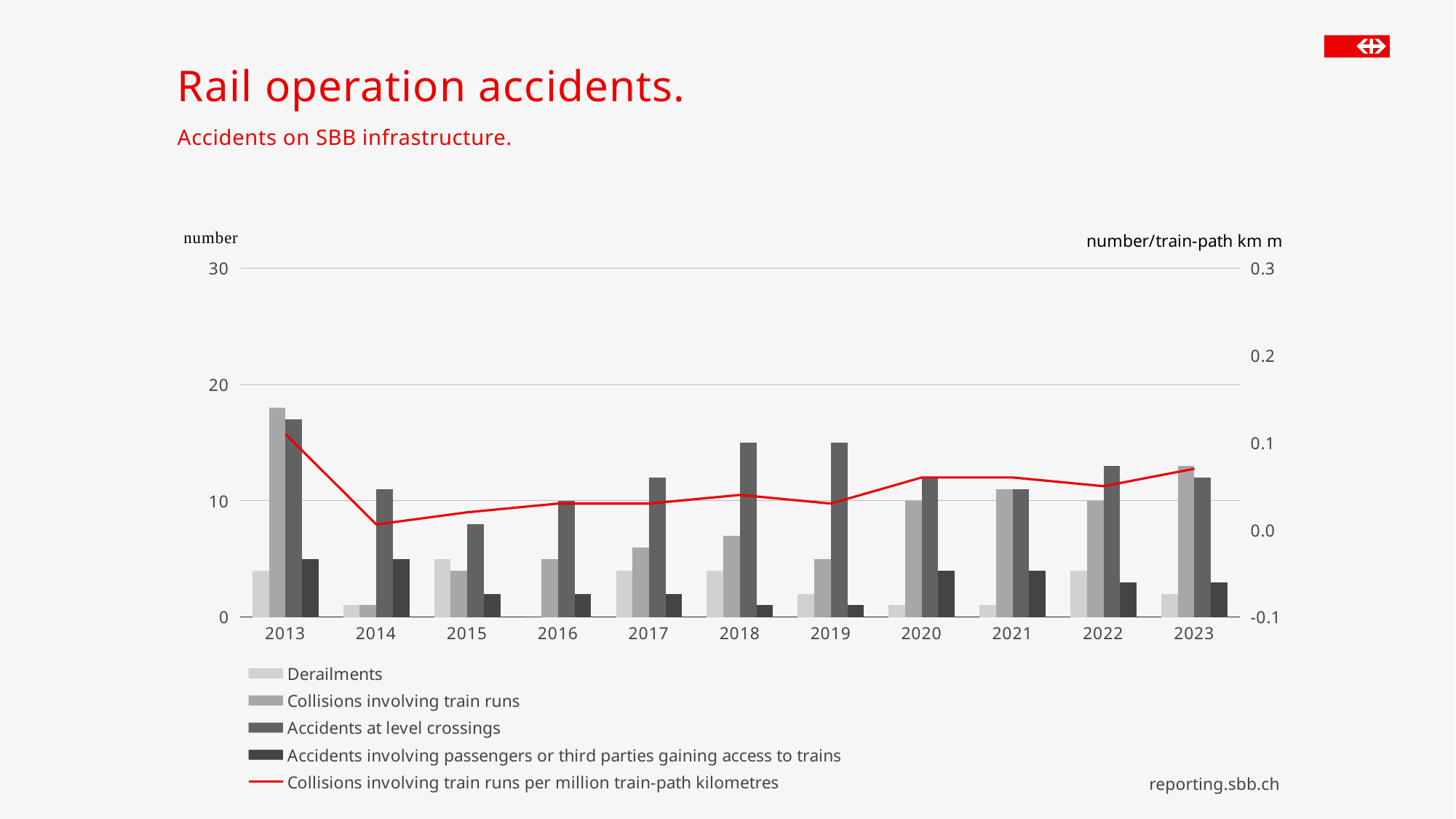
What is the title of the chart slide? Rail operation accidents. How many series does the legend list? 5 In which year is the value for Collisions involving train runs highest? 2013 Is the value for Collisions involving train runs in 2013 greater or less than 10? greater In which year is the value for Accidents at level crossings highest? 2013 Which is larger: Accidents at level crossings in 2017 or in 2015? 2017 How many years are shown on the x axis of the chart? 11 Does the line for Collisions involving train runs per million train-path kilometres rise or fall from 2013 to 2014? fall What kind of chart is shown on the slide? bar chart with a line Which is larger: Collisions involving train runs in 2013 or in 2014? 2013 Is the value for Accidents at level crossings in 2015 greater or less than 10? less Is the value for Accidents at level crossings in 2018 greater or less than 10? greater